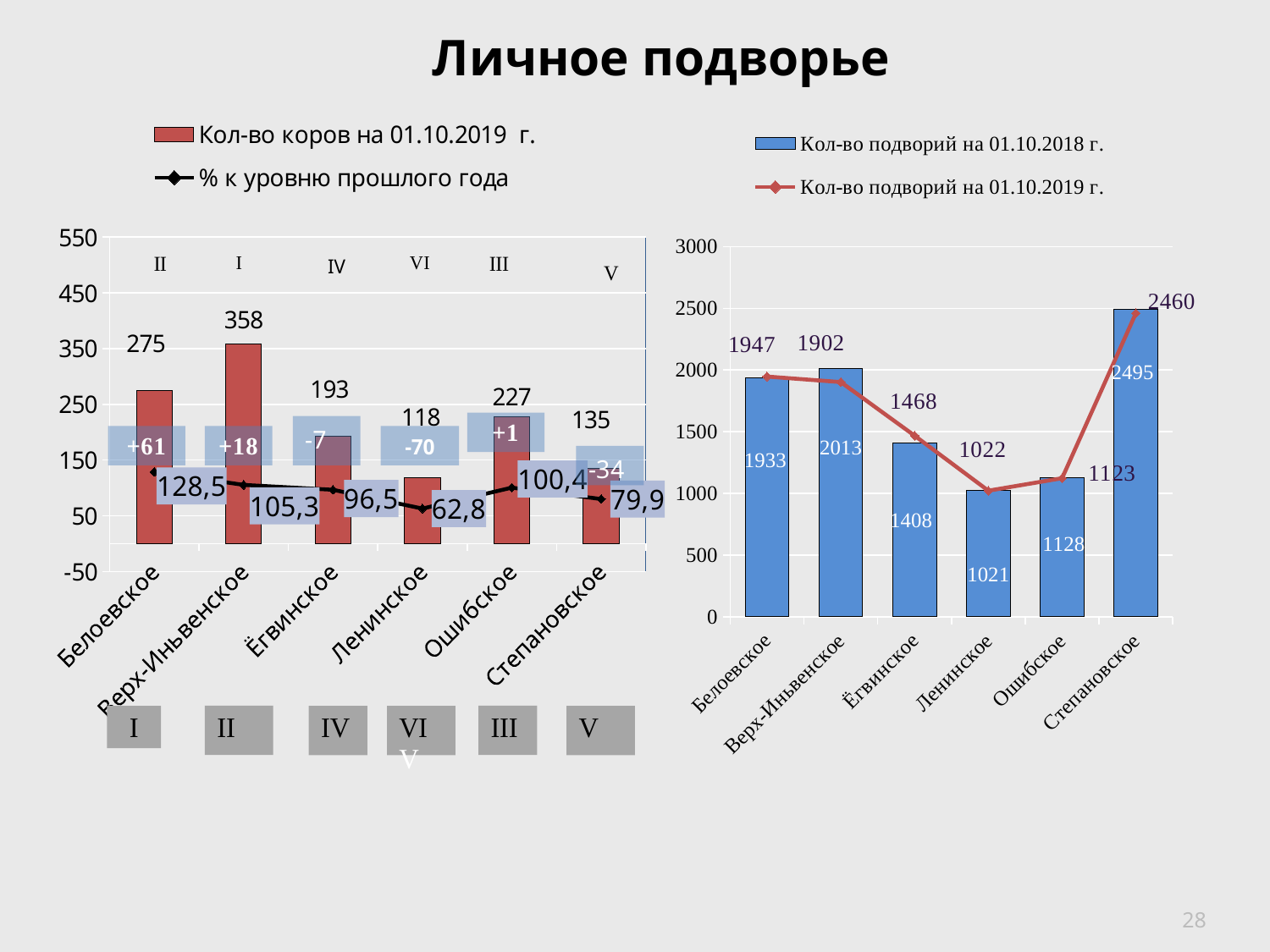
In the left chart, what is the value of % к уровню прошлого года for Ленинское? 62,8 In the right chart, what is the value of Кол-во подворий на 01.10.2018 г. for Ёгвинское? 1408 In the right chart, which category has the lowest value of Кол-во подворий на 01.10.2018 г.? Ленинское In the left chart, how many series does the legend list? 2 In the left chart, what is the number of cows (Кол-во коров на 01.10.2019 г.) for Верх-Иньвенское? 358 In the left chart, which category has the highest value of % к уровню прошлого года? Белоевское How many categories are shown on the x axis of the right chart? 6 In the right chart, what is the value of Кол-во подворий на 01.10.2019 г. for Степановское? 2460 In the left chart, which category has the lowest number of cows (Кол-во коров на 01.10.2019 г.)? Ленинское In the right chart, which is larger for Верх-Иньвенское: Кол-во подворий на 01.10.2018 г. or Кол-во подворий на 01.10.2019 г.? Кол-во подворий на 01.10.2018 г. In the left chart, what is the difference in the number of cows between Верх-Иньвенское and Белоевское? 83 In the right chart, what is the difference between Кол-во подворий на 01.10.2018 г. and Кол-во подворий на 01.10.2019 г. for Ошибское? 5